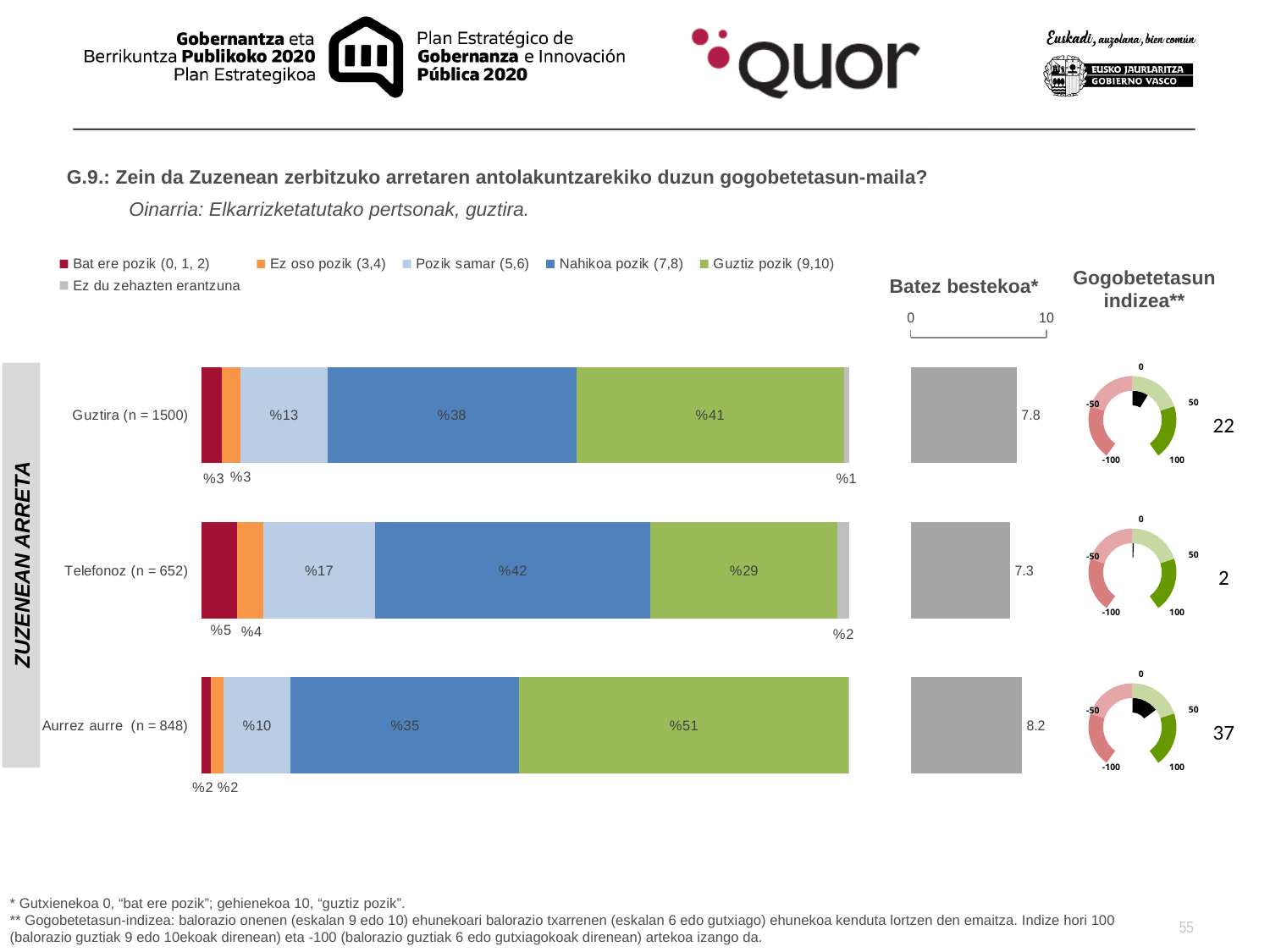
In the 'Batez bestekoa*' bar chart, what is the value for Telefonoz (n = 652)? 7.3 In the stacked bar chart, what is the difference between the 'Guztiz pozik (9,10)' values for Aurrez aurre (n = 848) and Telefonoz (n = 652)? 22 percentage points In the stacked bar chart, what is the value of 'Guztiz pozik (9,10)' for Aurrez aurre (n = 848)? %51 In the 'Gogobetetasun indizea**' gauges, which category has the lowest index? Telefonoz (n = 652) How many categories (rows) does the stacked bar chart show? 3 In the stacked bar chart, what is the value of 'Pozik samar (5,6)' for Guztira (n = 1500)? %13 How many series does the legend of the stacked bar chart list? 6 In the 'Batez bestekoa*' bar chart, which category has the highest value? Aurrez aurre (n = 848) In the 'Gogobetetasun indizea**' gauges, what is the index value for Guztira (n = 1500)? 22 In the stacked bar chart, which is larger for Guztira (n = 1500): 'Nahikoa pozik (7,8)' or 'Guztiz pozik (9,10)'? Guztiz pozik (9,10) In the stacked bar chart, what is the value of 'Nahikoa pozik (7,8)' for Telefonoz (n = 652)? %42 What kind of chart is used to show the satisfaction levels by category? Stacked bar chart